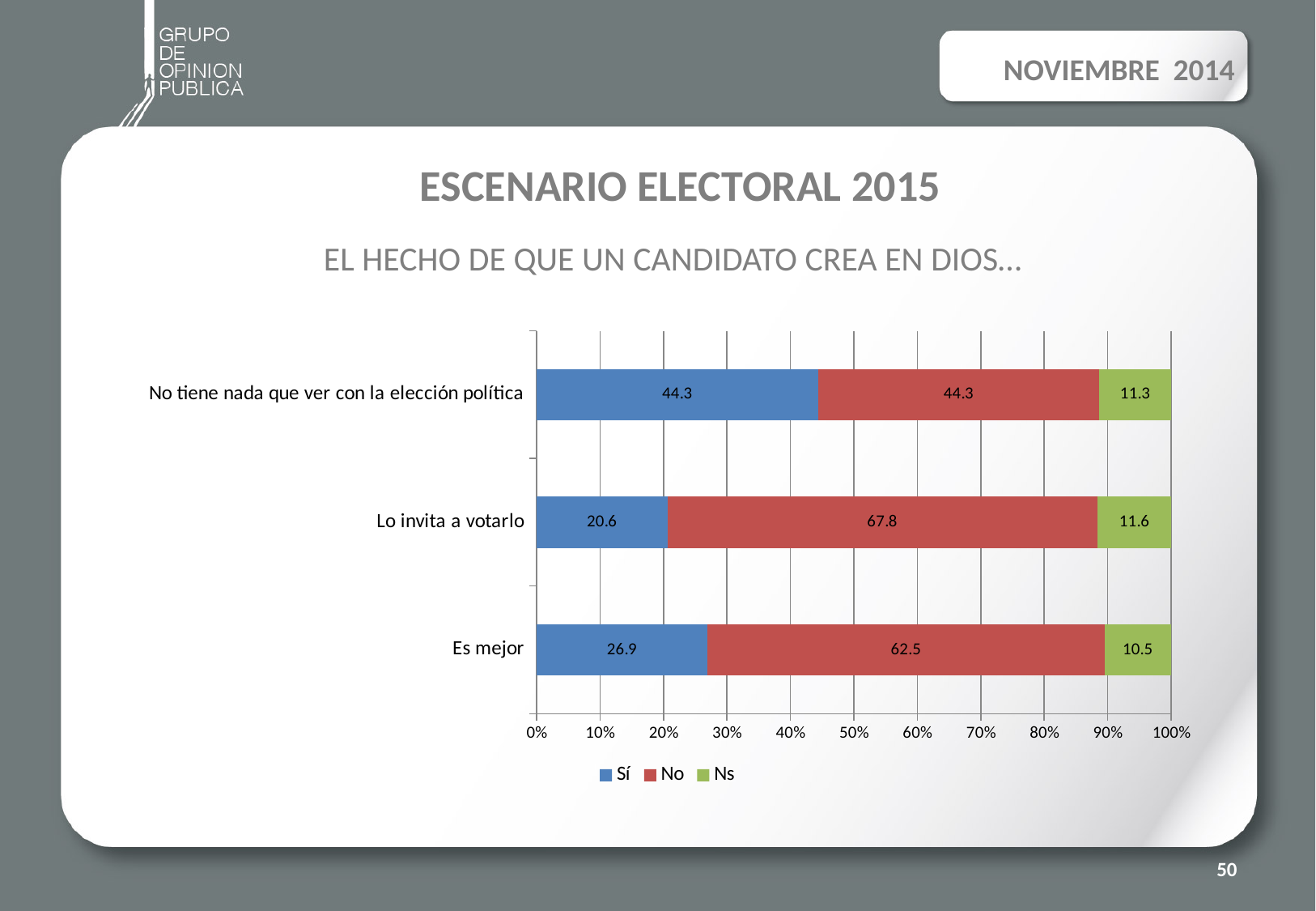
How many series does the legend list? 3 What is the 'Ns' value for 'No tiene nada que ver con la elección política'? 11.3 What is the 'Sí' value for 'Lo invita a votarlo'? 20.6 What is the difference between the 'No' values for 'Lo invita a votarlo' and 'Es mejor'? 5.3 Which category has the lowest 'Sí' value? Lo invita a votarlo How many categories are shown on the chart? 3 What kind of chart is shown on the slide? Stacked bar chart What is the 'No' value for 'Es mejor'? 62.5 Which category has the highest 'No' value? Lo invita a votarlo Which series is shown in green in the legend? Ns What is the total of the stacked bar for 'Es mejor'? 99.9 Which is larger: the 'Sí' value for 'Es mejor' or the 'Sí' value for 'Lo invita a votarlo'? Es mejor